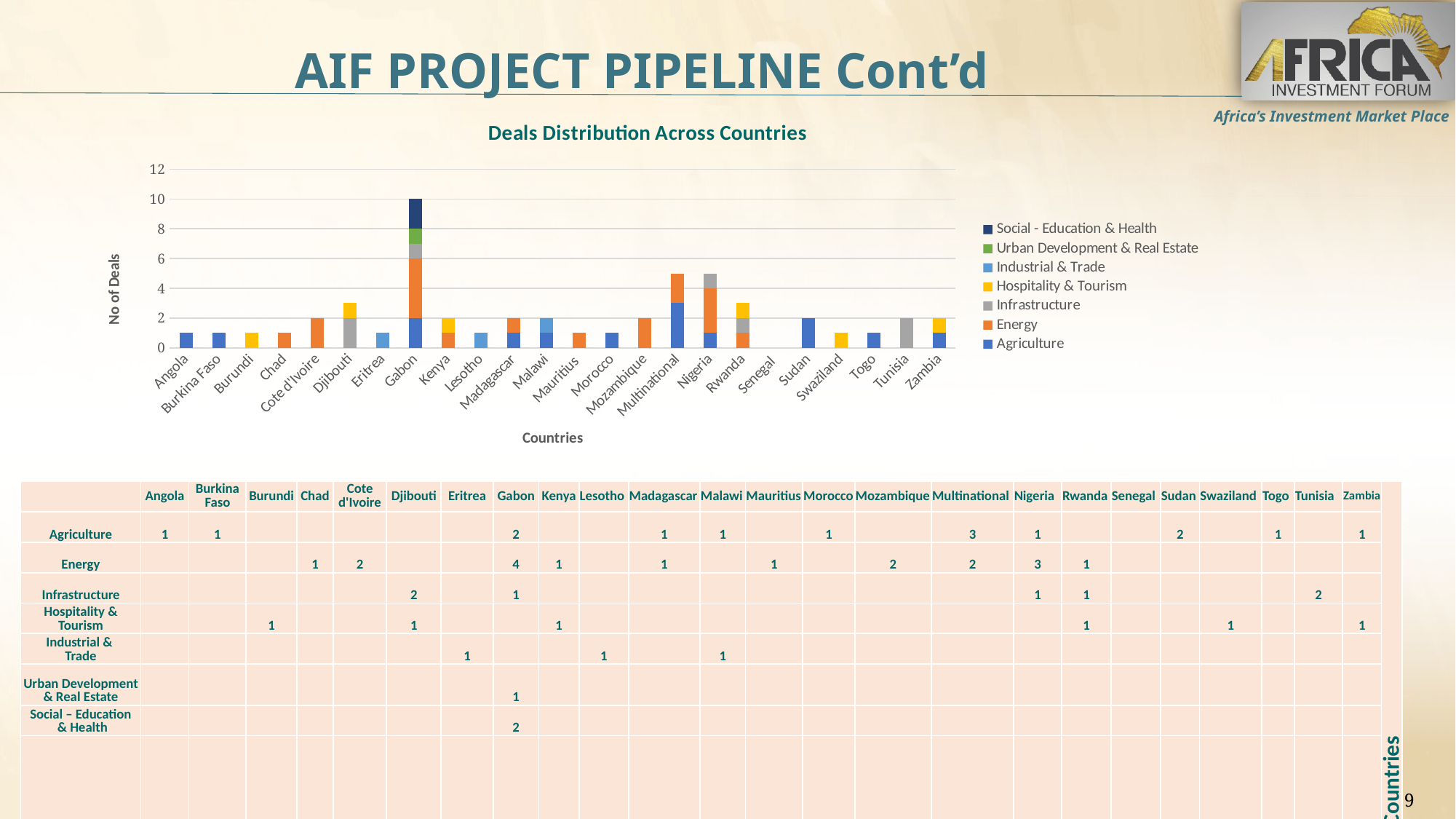
What is the title of the chart? Deals Distribution Across Countries How many Energy deals does Gabon have? 4 How many series does the chart legend list? 7 Which has more total deals, Gabon or Multinational? Gabon How many Infrastructure deals does Tunisia have? 2 What is the total number of deals for Gabon? 10 What type of chart is shown on the slide? stacked bar chart How many Agriculture deals are listed for Multinational? 3 Which country has the highest total number of deals? Gabon What is the total number of deals for Nigeria? 5 How many countries are shown on the x axis of the chart? 24 What is the difference between the Energy deals for Nigeria and for Rwanda? 2